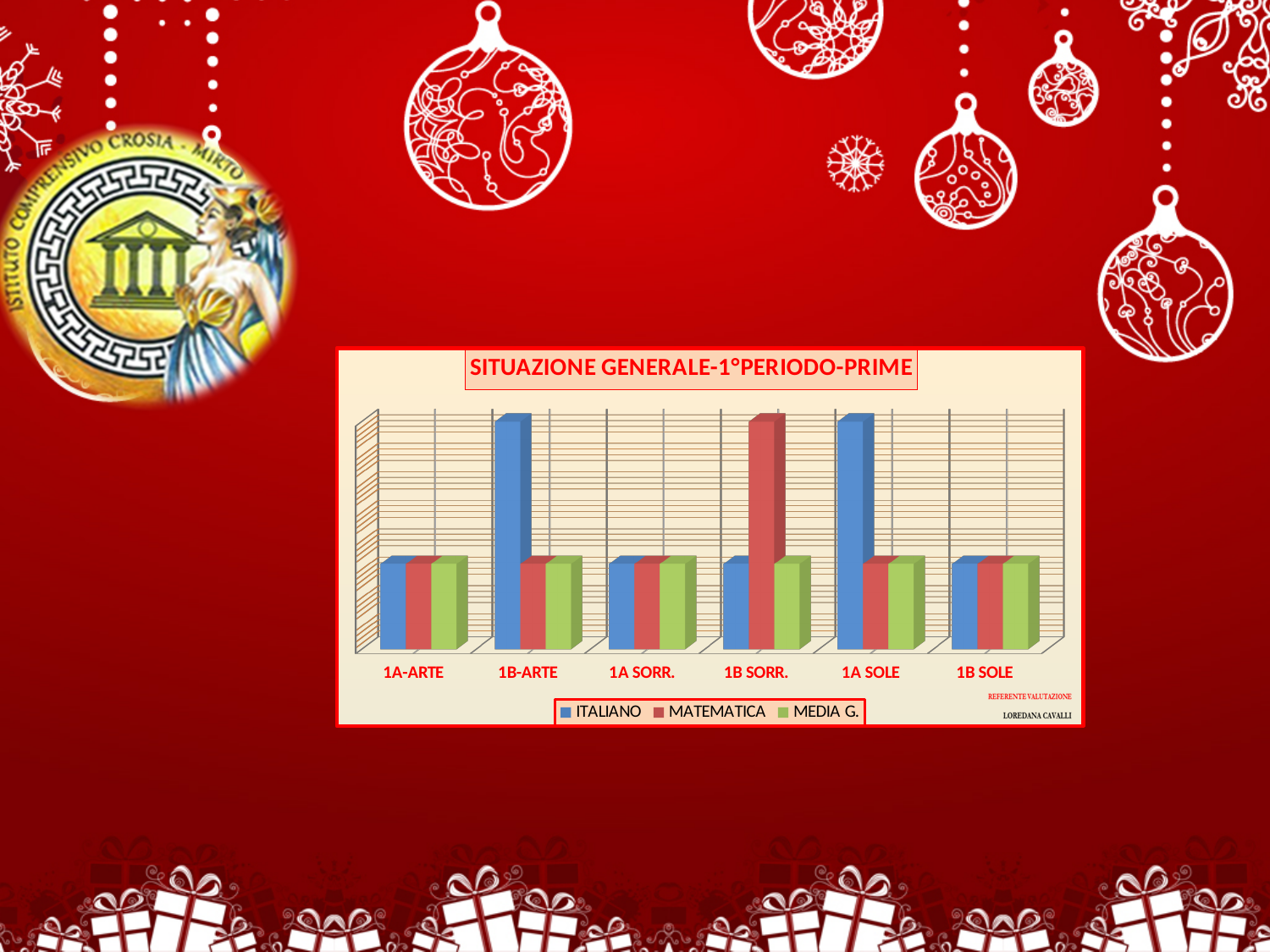
Which series has the highest value for 1B-ARTE? ITALIANO How many series does the legend list? 3 How many categories are shown on the x axis? 6 Which series is shown in blue in the legend? ITALIANO What kind of chart is shown on the slide? bar chart Which series has the highest value for 1B SORR.? MATEMATICA For 1B SORR., which is larger: ITALIANO or MATEMATICA? MATEMATICA Which category has the highest MATEMATICA value? 1B SORR. For 1B-ARTE, which is larger: ITALIANO or MATEMATICA? ITALIANO For 1A SOLE, which is larger: ITALIANO or MEDIA G.? ITALIANO What is the title of the chart? SITUAZIONE GENERALE-1°PERIODO-PRIME